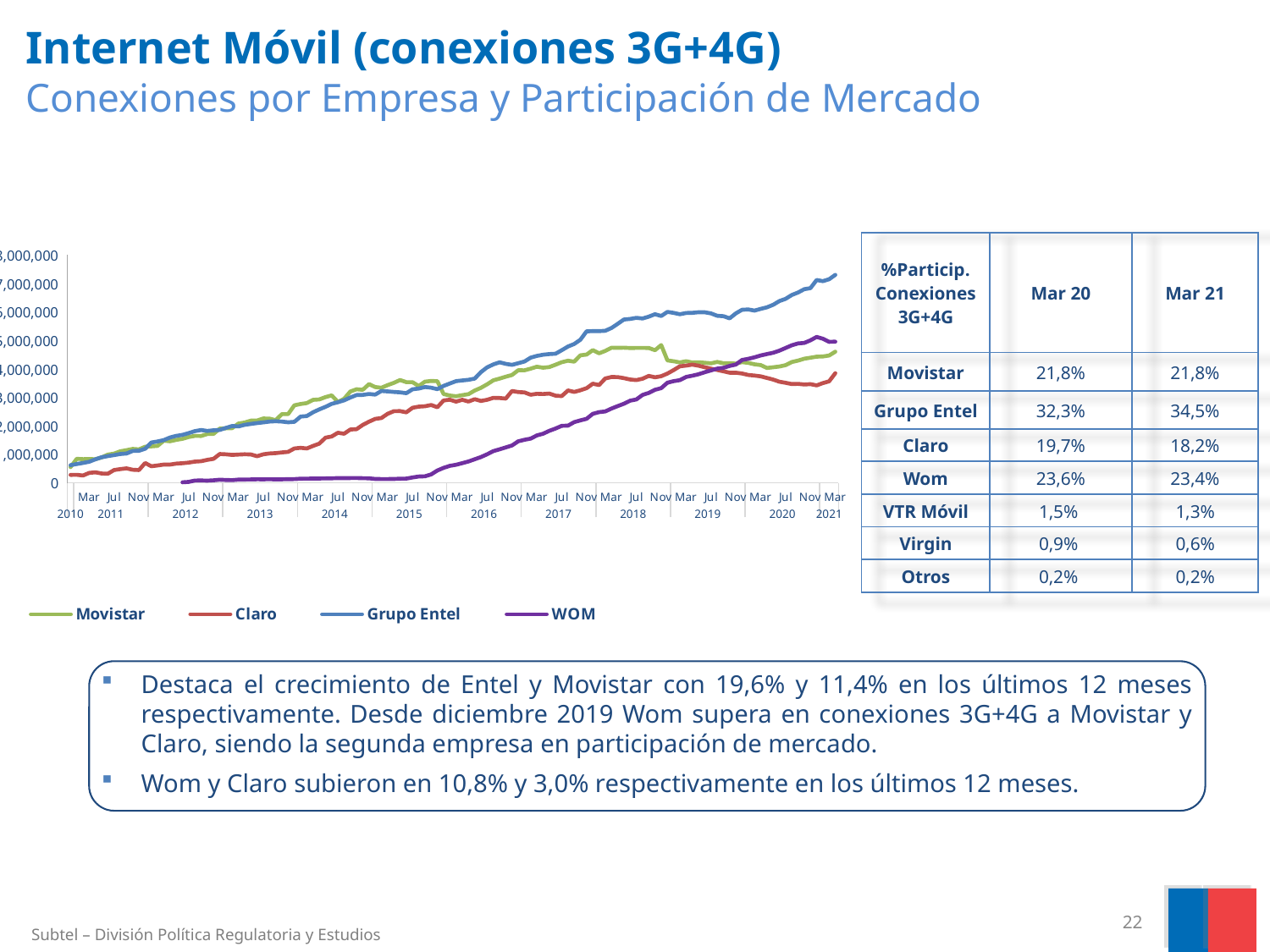
At Mar 2021, which is larger, the value for WOM or the value for Claro? WOM Is the value for WOM at Mar 2021 greater or less than 6,000,000? less Which series has the highest value at the end of the chart (Mar 2021)? Grupo Entel Is the value for Movistar at Mar 2021 greater or less than 4,000,000? greater Is the value for Claro at Mar 2021 greater or less than 5,000,000? less Which series starts at 0 in 2012 and stays near 0 until about 2015? WOM How many series does the chart legend list? 4 Which companies are listed in the chart legend? Movistar, Claro, Grupo Entel, WOM What kind of chart is shown on the slide? line chart Does the Grupo Entel line generally rise or fall from 2010 to 2021? rise Which series has the lowest value at the end of the chart (Mar 2021)? Claro